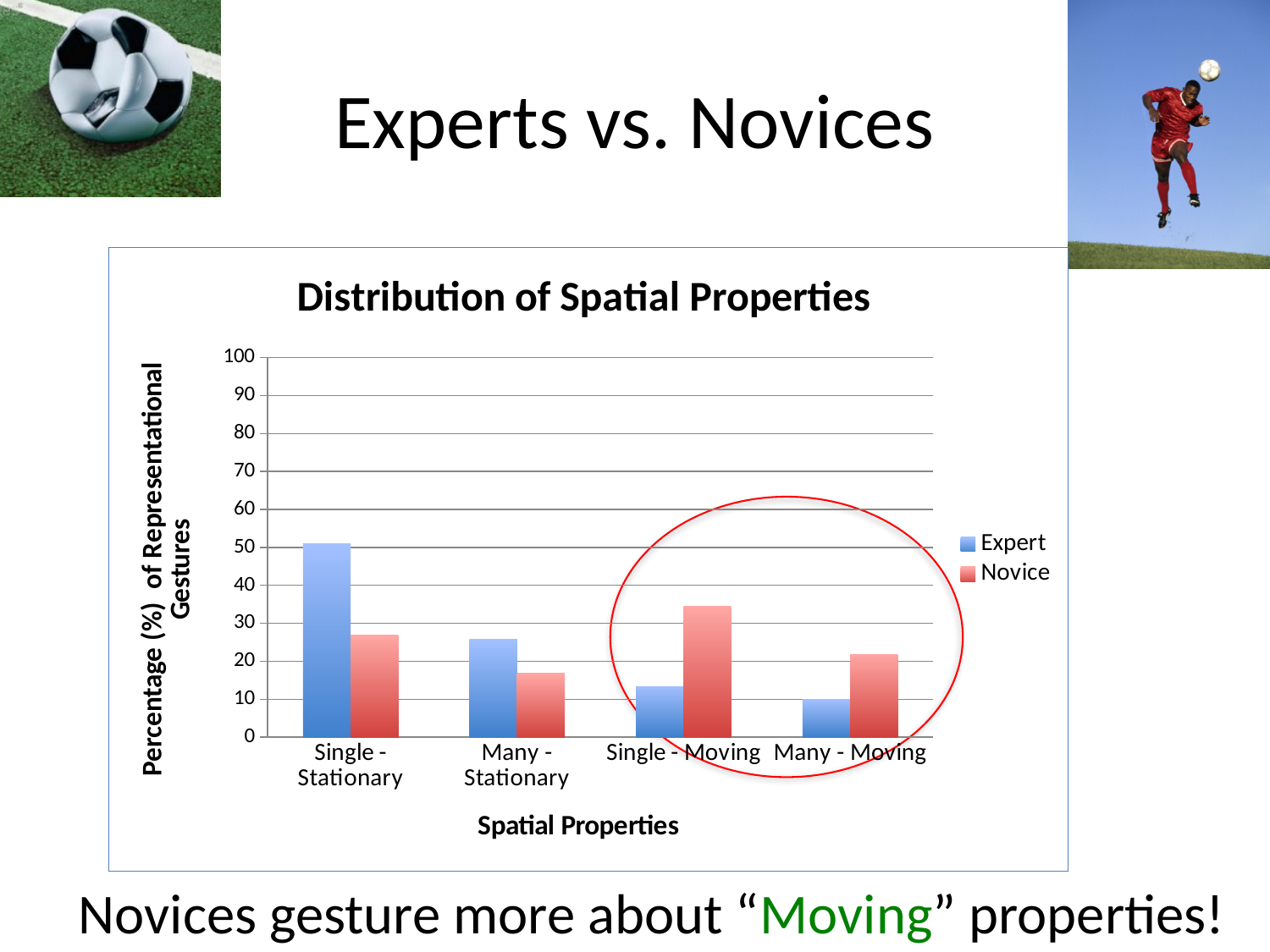
Which category has the highest Novice value? Single - Moving How many categories are shown on the x axis? 4 Is the Novice value for Many - Moving greater or less than 30? less For Single - Stationary, which series has the larger value, Expert or Novice? Expert How many series does the legend list? 2 What kind of chart is shown on the slide? bar chart For Single - Moving, which series has the larger value, Expert or Novice? Novice What is the title of the chart? Distribution of Spatial Properties Which category has the lowest Novice value? Many - Stationary Which category has the lowest Expert value? Many - Moving Which category has the highest Expert value? Single - Stationary